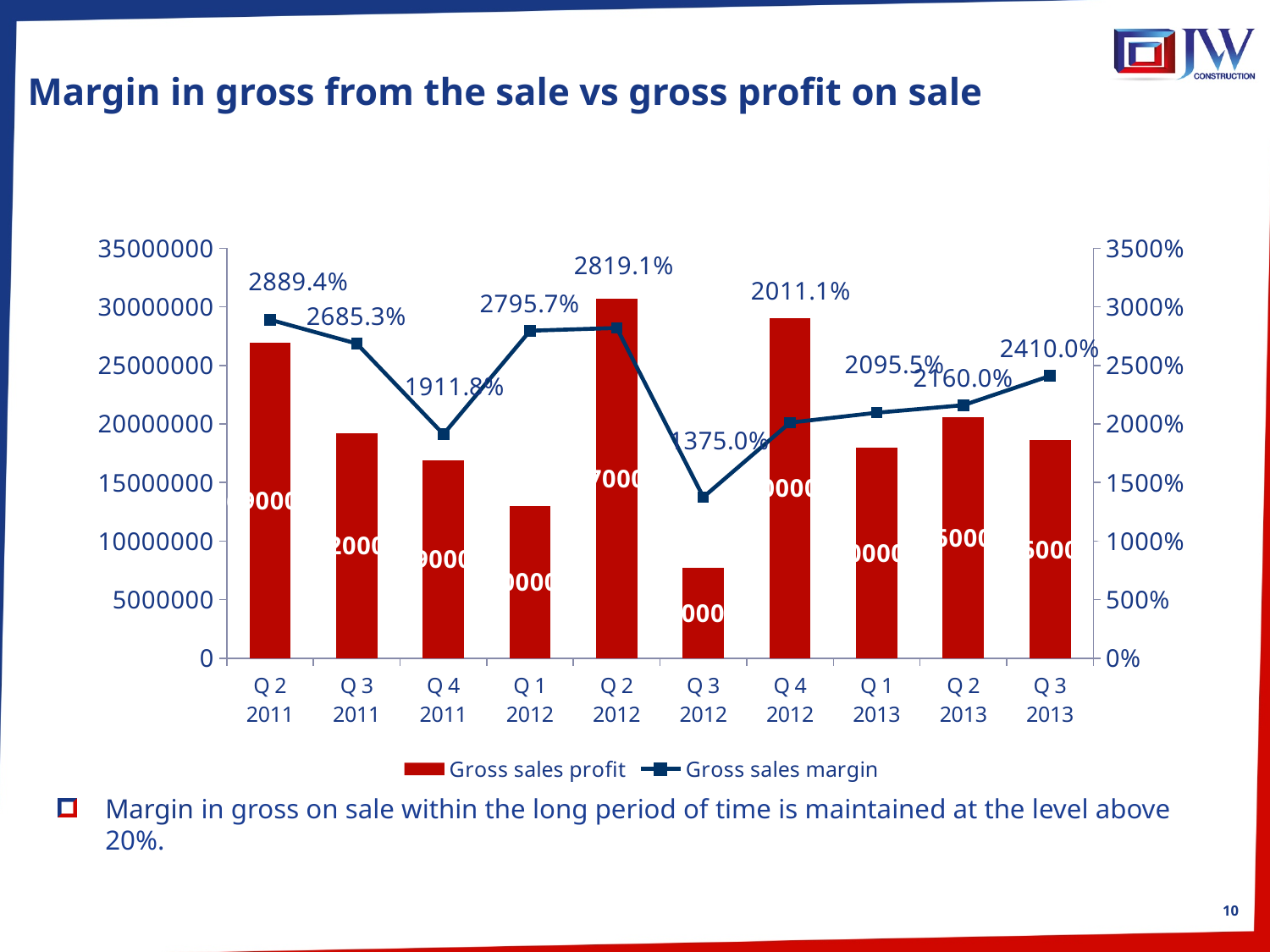
Which quarter has the highest Gross sales margin? Q 2 2011 How many quarters are shown on the x axis? 10 Which is larger, the Gross sales margin for Q 4 2011 or for Q 4 2012? Q 4 2012 Is the Gross sales profit for Q 2 2011 greater or less than 25000000? greater How many series does the legend list? 2 What is the Gross sales margin for Q 3 2013? 2410.0% What is the Gross sales margin for Q 3 2012? 1375.0% Which quarter has the lowest Gross sales margin? Q 3 2012 Which quarter has the lowest Gross sales profit bar? Q 3 2012 Is the Gross sales profit for Q 3 2012 greater or less than 10000000? less What is the Gross sales margin for Q 2 2011? 2889.4% What is the difference between the Gross sales margin for Q 2 2012 and Q 3 2012? 1444.1 percentage points